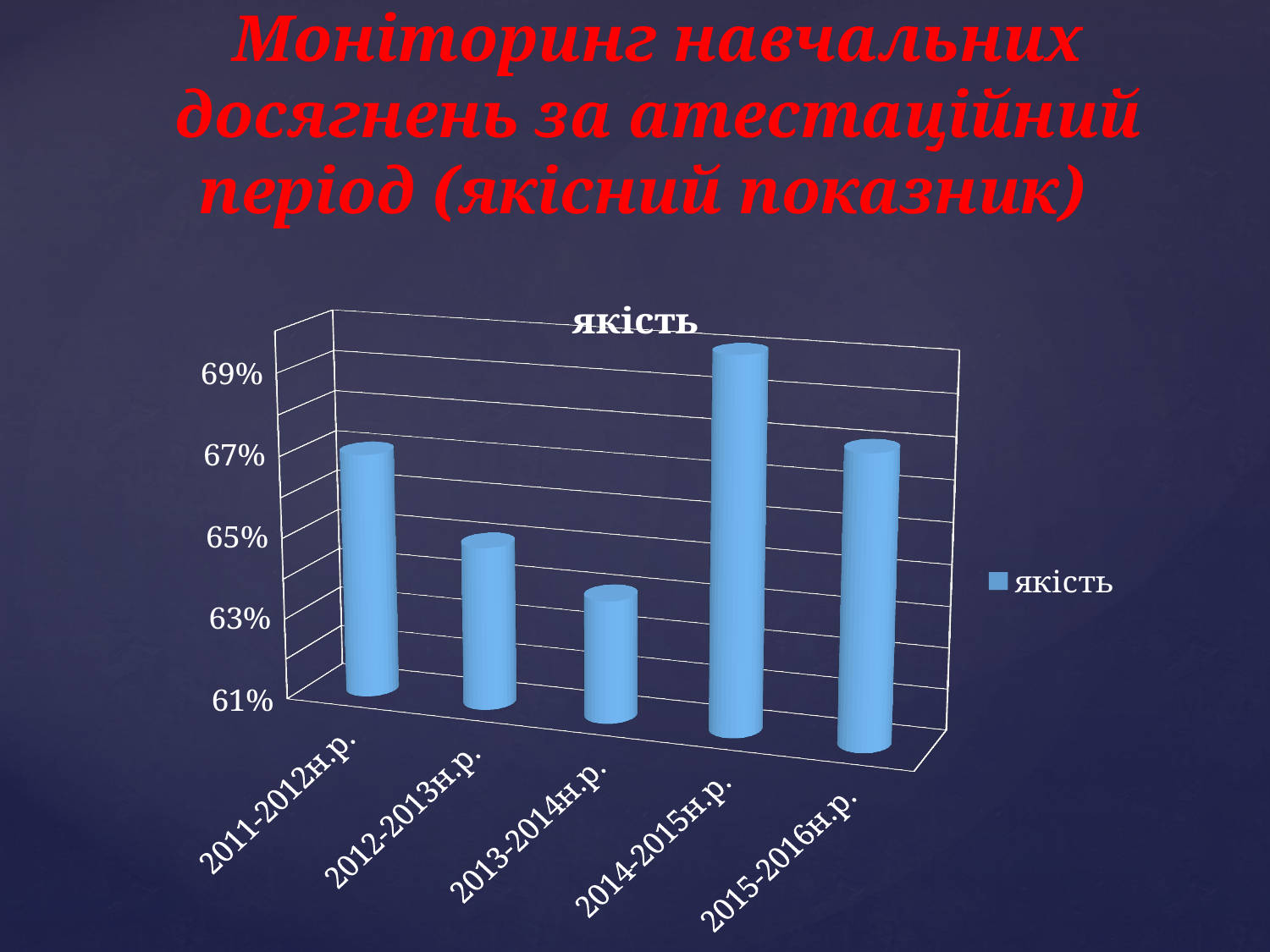
Is the value for 2014-2015н.р. greater or less than 67%? greater Is the value for 2013-2014н.р. greater or less than 65%? less Which is larger, the value for 2011-2012н.р. or the value for 2013-2014н.р.? 2011-2012н.р. How many series does the chart legend list? 1 Which is larger, the value for 2014-2015н.р. or the value for 2012-2013н.р.? 2014-2015н.р. Which school year has the lowest value in the chart? 2013-2014н.р. Do the values rise or fall from 2011-2012н.р. to 2013-2014н.р.? fall How many school years (categories) are shown on the x axis of the chart? 5 What kind of chart is shown on the slide? bar chart Which school year has the highest value in the chart? 2014-2015н.р. Is the value for 2012-2013н.р. greater or less than 63%? greater What is the title of the chart? якість